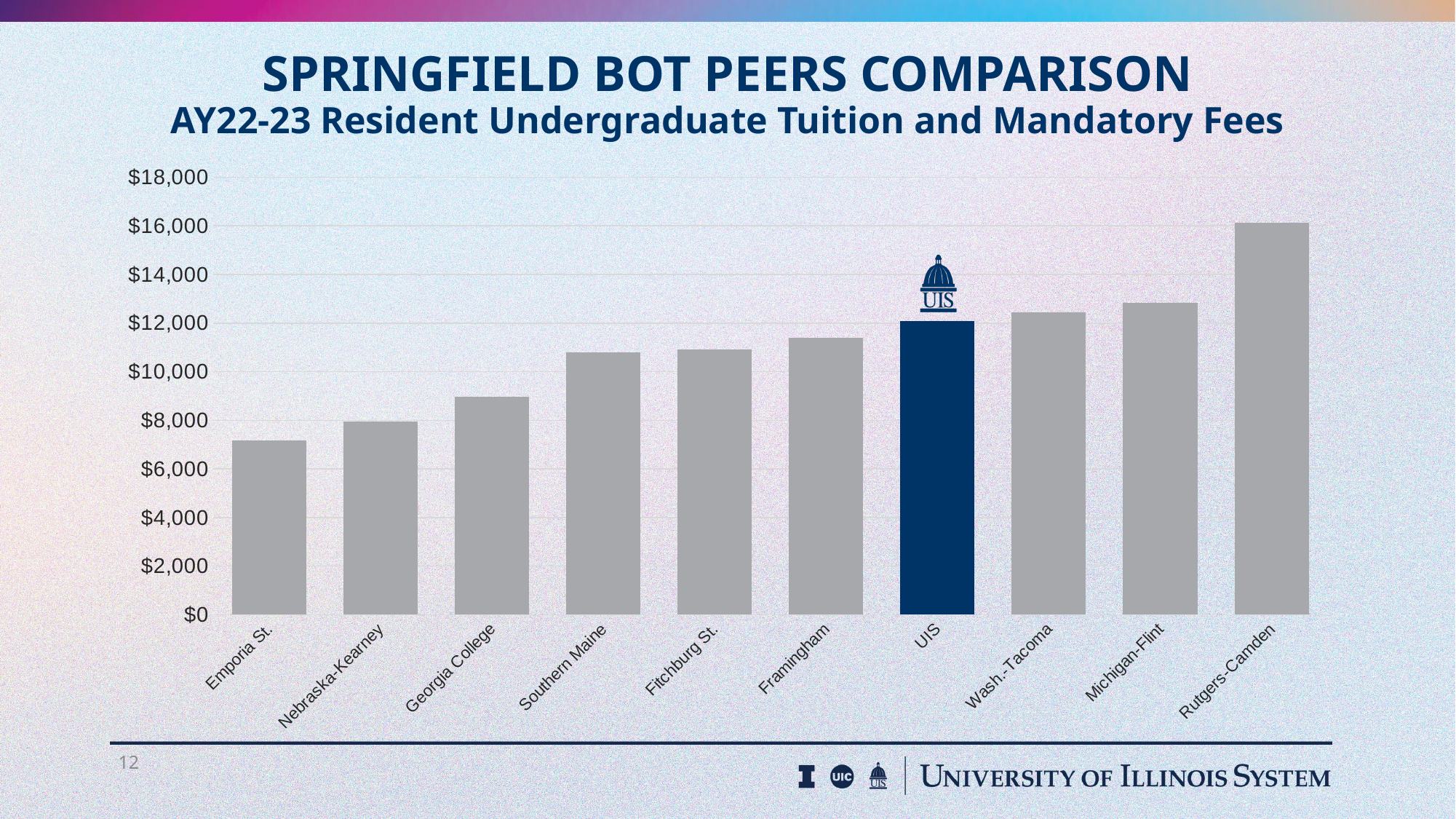
Is the value for Emporia St. greater or less than $8,000? less Which institution has the highest resident undergraduate tuition and mandatory fees? Rutgers-Camden Is the value for Michigan-Flint greater or less than $14,000? less Is the value for Georgia College greater or less than $10,000? less Do the values generally rise or fall from left to right across the chart? rise Which is larger, the value for Framingham or the value for Georgia College? Framingham Which bar is highlighted in dark blue rather than gray? UIS Which institution has the lowest resident undergraduate tuition and mandatory fees? Emporia St. How many institutions are shown on the chart? 10 What kind of chart is shown on the slide? bar chart